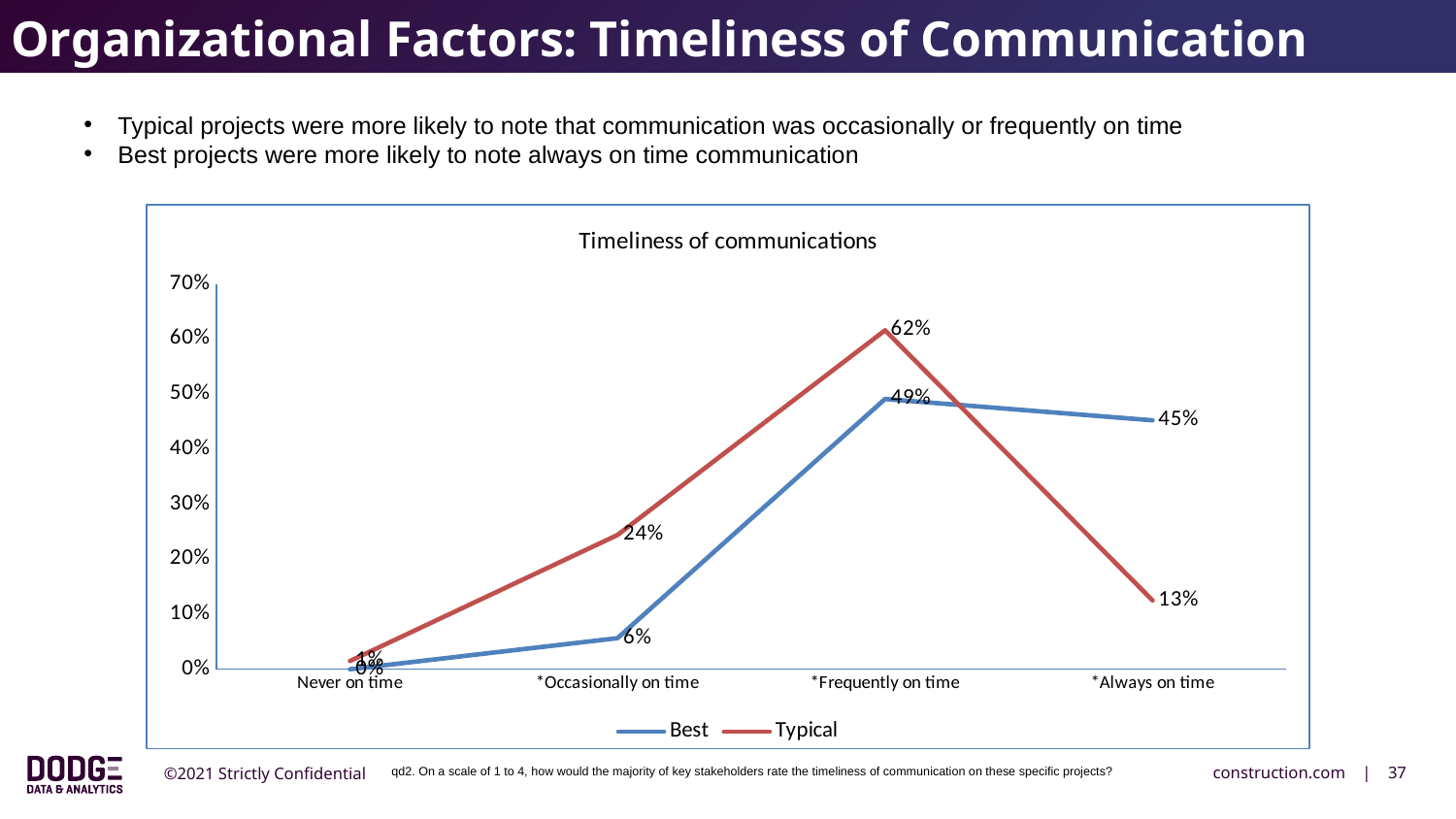
What is the title of the chart? Timeliness of communications What is the value for Best at *Always on time? 45% How many categories are shown on the x axis of the chart? 4 What is the value for Typical at *Frequently on time? 62% What type of chart is shown on the slide? Line chart What is the value for Typical at *Occasionally on time? 24% What is the value for Best at *Occasionally on time? 6% What is the difference between Typical and Best at *Occasionally on time? 18% At *Always on time, which series has the larger value, Best or Typical? Best Which category has the highest value for the Typical series? *Frequently on time How many series does the chart legend list? 2 Which series is drawn in red on the chart? Typical